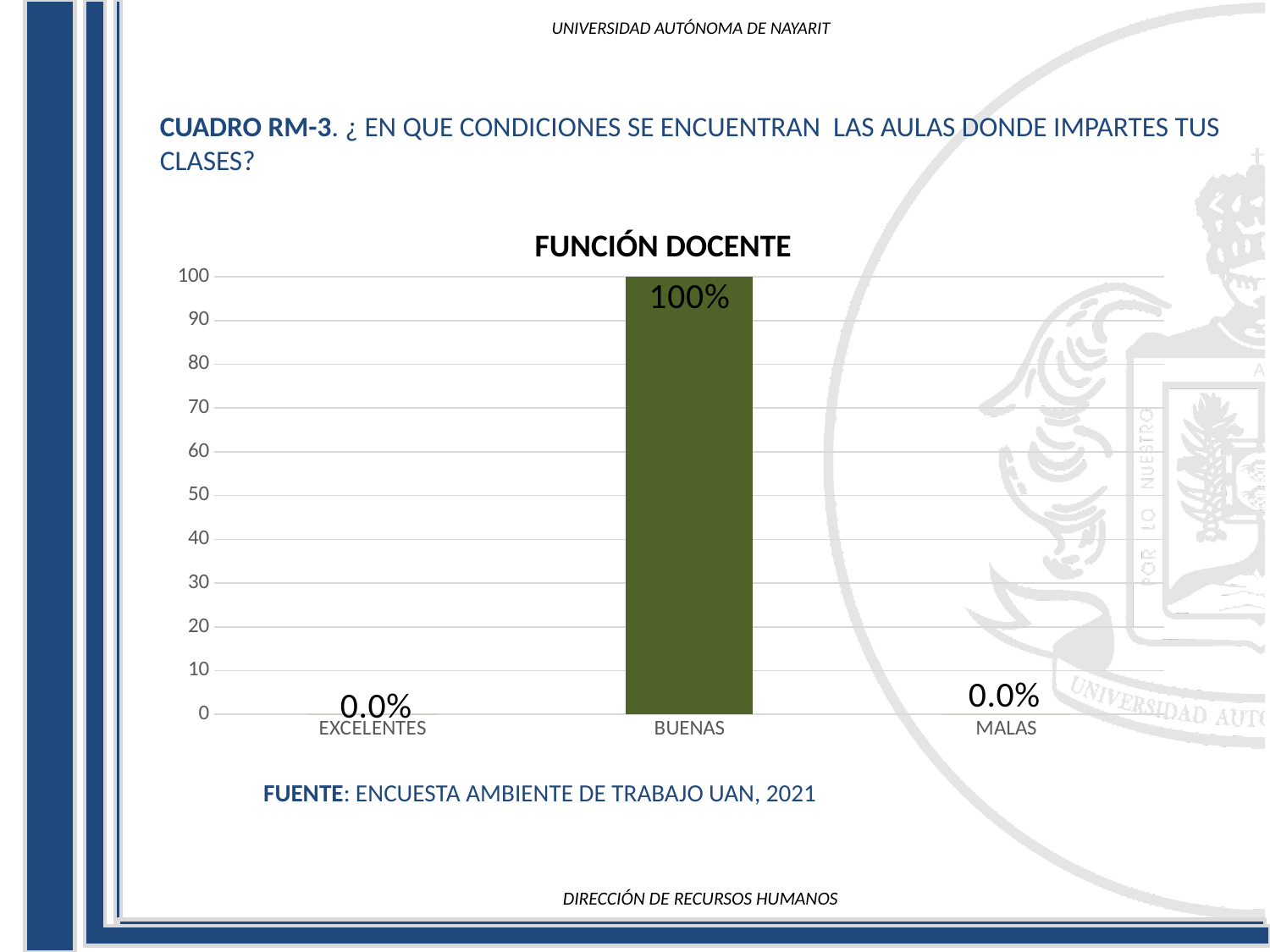
How many categories are shown on the x axis? 3 What is the value for MALAS? 0.0% Is the value for BUENAS greater or less than 50? greater What is the title of the chart? FUNCIÓN DOCENTE What is the value for BUENAS? 100% Which category has the highest value? BUENAS What is the maximum value shown on the y axis? 100 What kind of chart is shown? bar chart What is the difference between the values for BUENAS and MALAS? 100% Which is larger, the value for BUENAS or the value for EXCELENTES? BUENAS What is the value for EXCELENTES? 0.0%